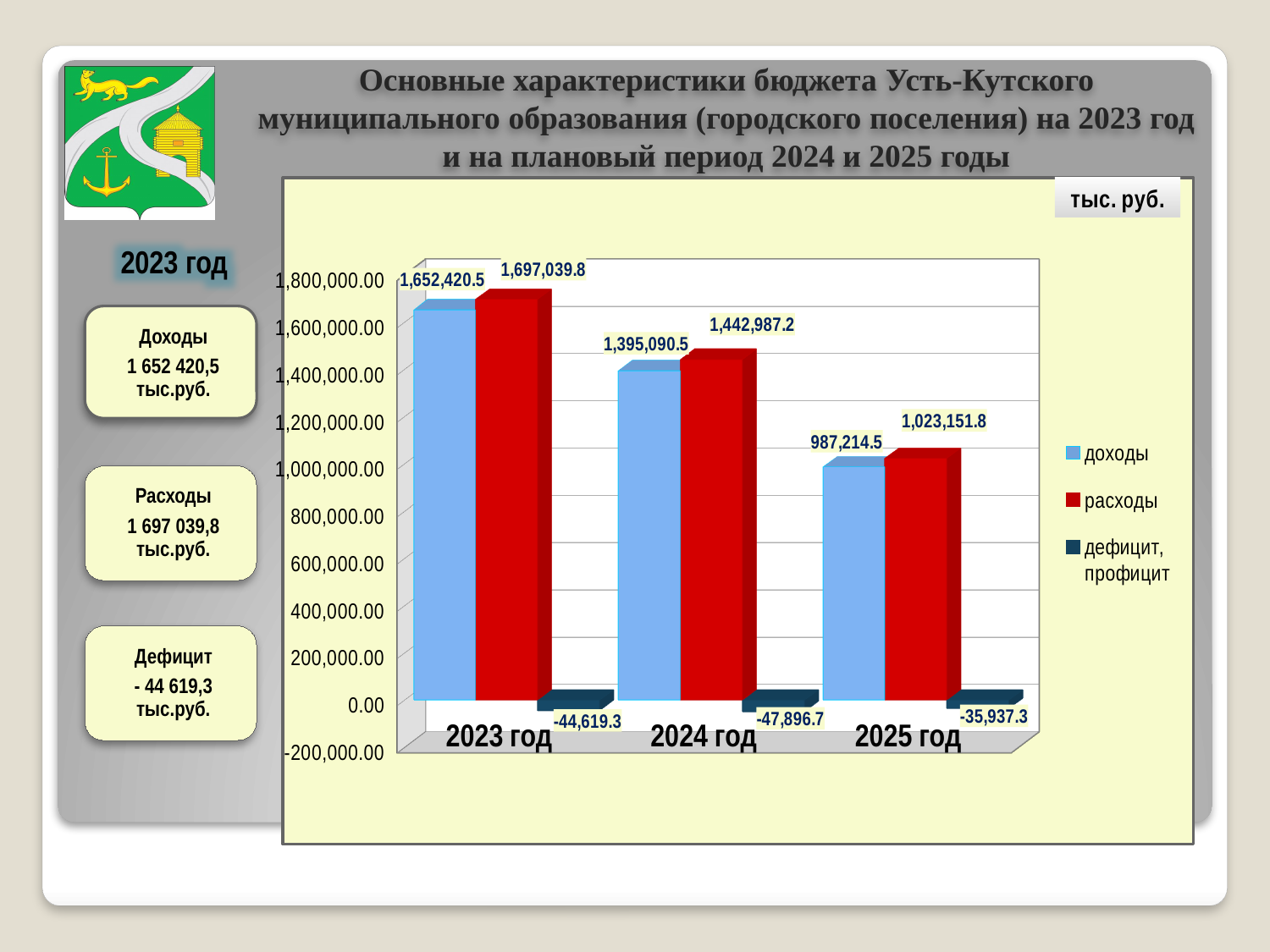
What is the value of расходы for 2024 год? 1,442,987.2 Which year has the lowest value of доходы? 2025 год What is the difference between расходы and доходы for 2023 год? 44,619.3 What is the value of доходы for 2023 год? 1,652,420.5 What type of chart is shown on the slide? bar chart How many years are shown on the x axis of the chart? 3 Which is larger for 2025 год: доходы or расходы? расходы Is the value of доходы for 2025 год greater or less than 1,000,000.00? less Which year has the highest value of расходы? 2023 год What is the difference between доходы for 2024 год and доходы for 2025 год? 407,876.0 How many series does the chart legend list? 3 What is the value of дефицит, профицит for 2025 год? -35,937.3